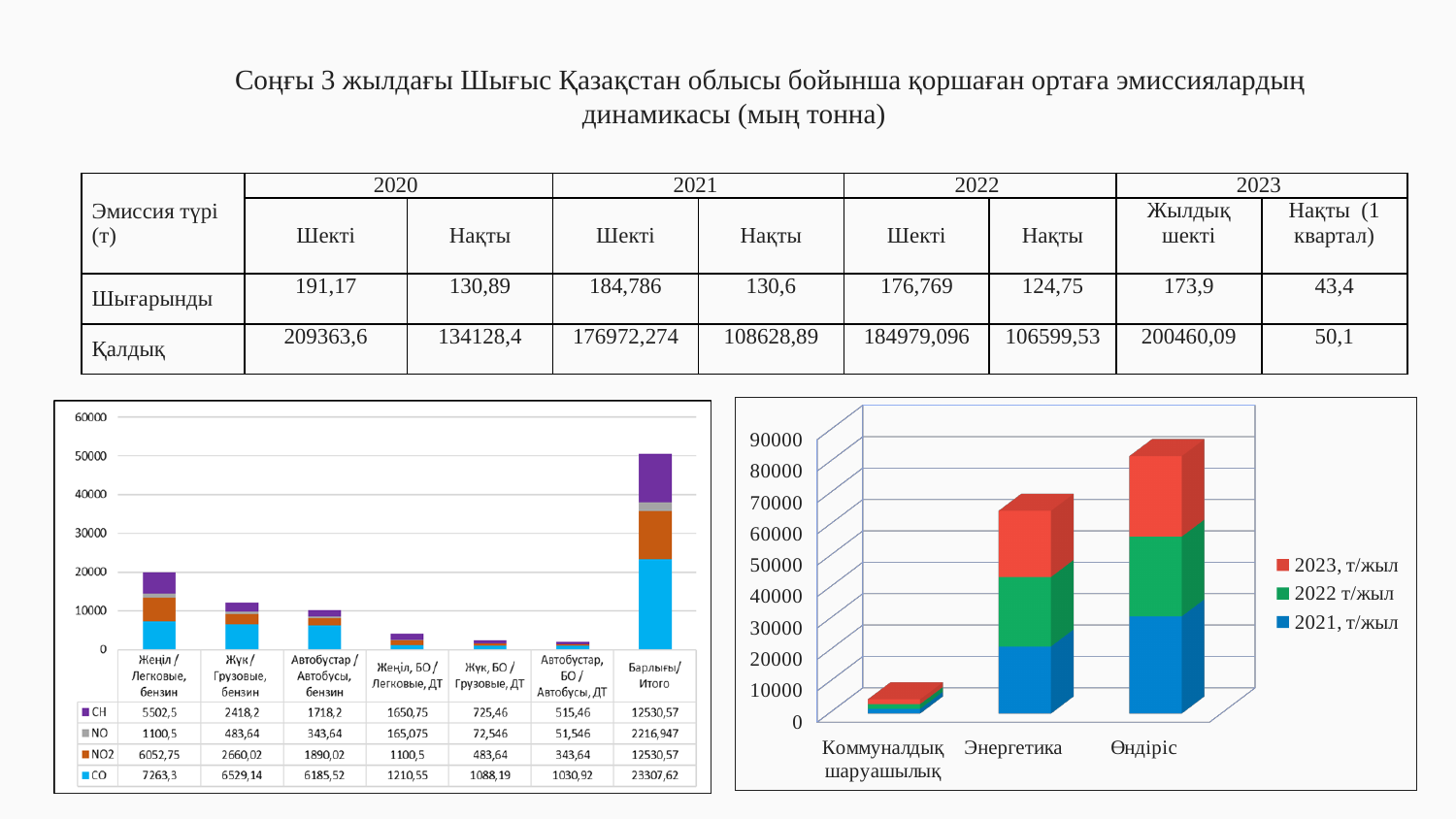
In the left chart, what is the NO value for Жүк / Грузовые, бензин? 483,64 What kind of chart is the right chart? Stacked bar chart How many series does the legend of the left chart list? 4 In the left chart, what is the difference between the CO values for Жеңіл / Легковые, бензин and Жүк / Грузовые, бензин? 734,16 In the left chart, what is the CH value for Барлығы / Итого? 12530,57 In the left chart, which category has the highest CO value? Барлығы / Итого How many series does the legend of the right chart list? 3 In the right chart, which category has the highest total bar? Өндіріс What kind of chart is the left chart? Stacked bar chart In the left chart, what is the NO2 value for Автобустар / Автобусы, бензин? 1890,02 In the left chart, what is the CO value for Жеңіл / Легковые, бензин? 7263,3 In the right chart, is the total value for Энергетика greater or less than 60000? greater